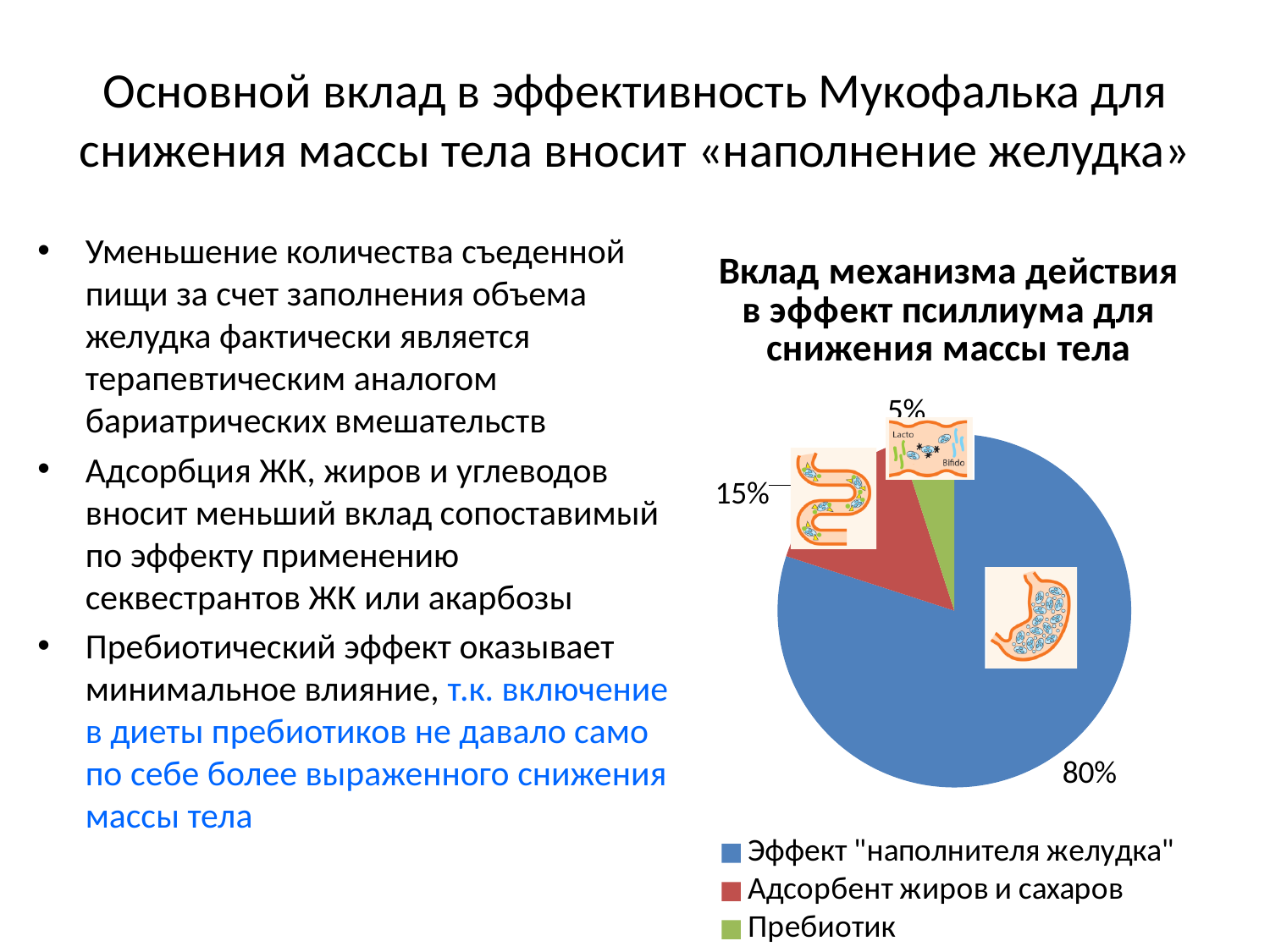
Which slice of the pie is the smallest? Пребиотик What share of the pie does Адсорбент жиров и сахаров have? 15% Which slice of the pie is the largest? Эффект "наполнителя желудка" What share of the pie does Эффект "наполнителя желудка" have? 80% How many entries does the legend list? 3 What share of the pie does Пребиотик have? 5% Which is larger: the share of Адсорбент жиров и сахаров or the share of Пребиотик? Адсорбент жиров и сахаров What kind of chart is shown on the slide? Pie chart What is the title of the chart? Вклад механизма действия в эффект псиллиума для снижения массы тела What is the difference between the shares of Эффект "наполнителя желудка" and Адсорбент жиров и сахаров? 65% What colour is the slice for Пребиотик? Green How many slices does the pie chart have? 3